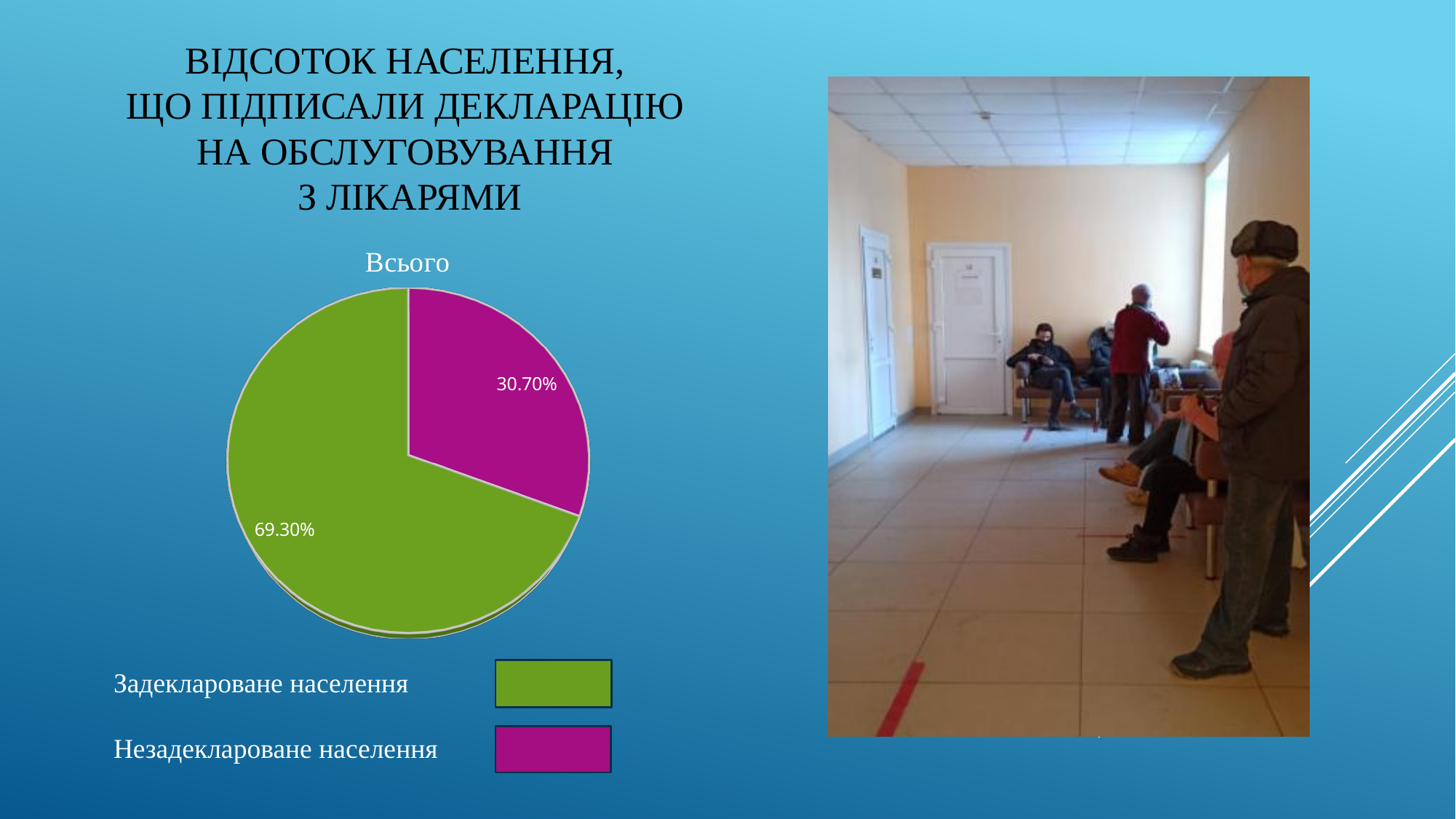
How many slices does the pie chart have? 2 Which is larger: the share of Задекларoване населення or Незадекларoване населення? Задекларoване населення What is the difference between the shares of Задекларoване населення and Незадекларoване населення? 38.60% What type of chart is shown on the slide? pie chart What share of the pie does Задекларoване населення have? 69.30% Which slice of the pie is the smallest? Незадекларoване населення Which slice of the pie is the largest? Задекларoване населення What is the title of the pie chart? Всього What share of the pie does Незадекларoване населення have? 30.70% How many entries does the legend list? 2 What colour is the slice for Незадекларoване населення? magenta